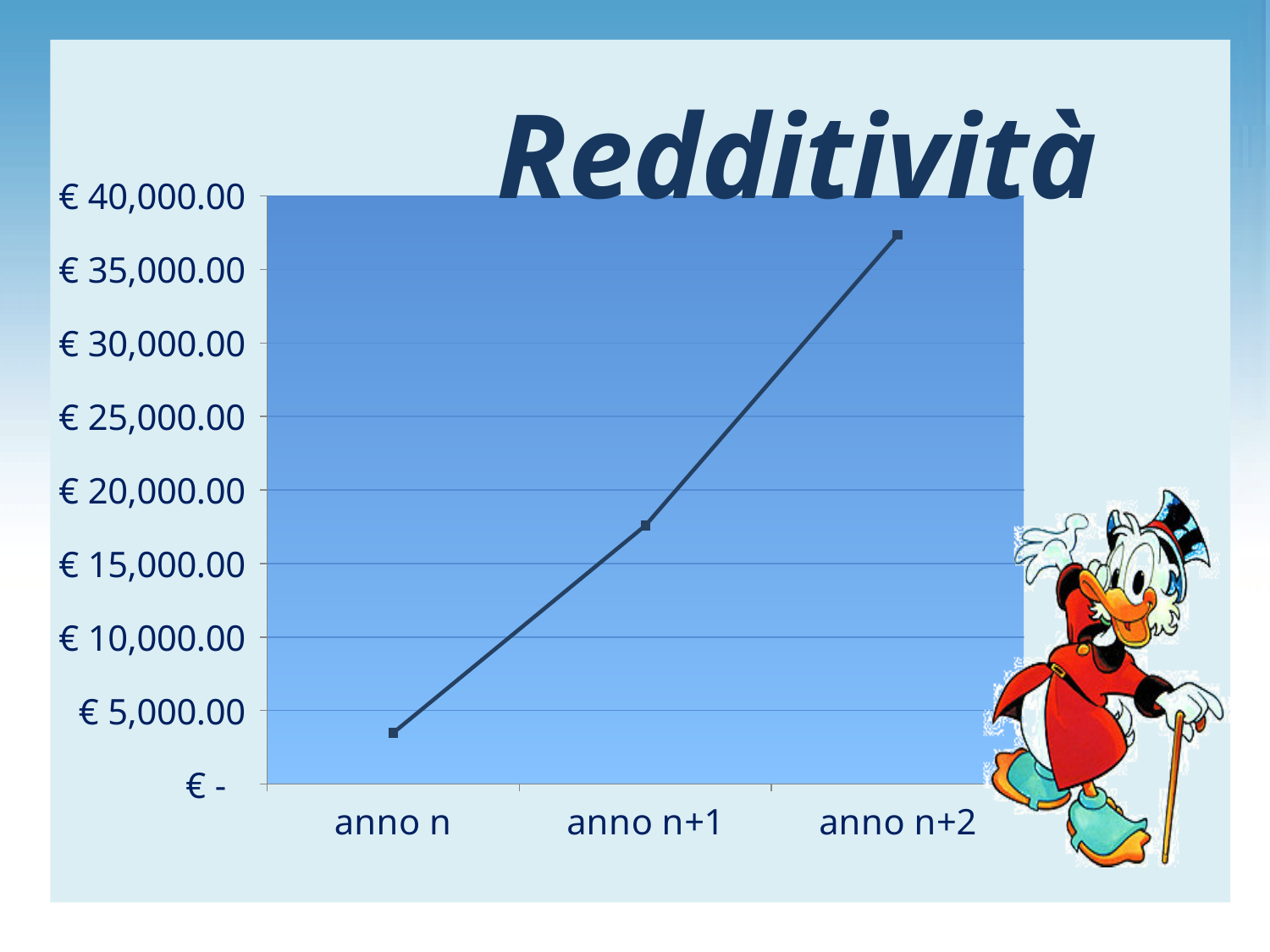
What is the title of the chart? Redditività Which is larger, the value for anno n+1 or the value for anno n? anno n+1 What is the highest value shown on the vertical axis? € 40,000.00 Is the value for anno n greater or less than € 5,000.00? less Do the values rise or fall from anno n to anno n+2? rise Is the value for anno n+1 greater or less than € 20,000.00? less Which category has the lowest value? anno n Which category has the highest value? anno n+2 How many points are plotted on the line? 3 What kind of chart is shown on the slide? line chart Is the value for anno n+1 greater or less than € 15,000.00? greater